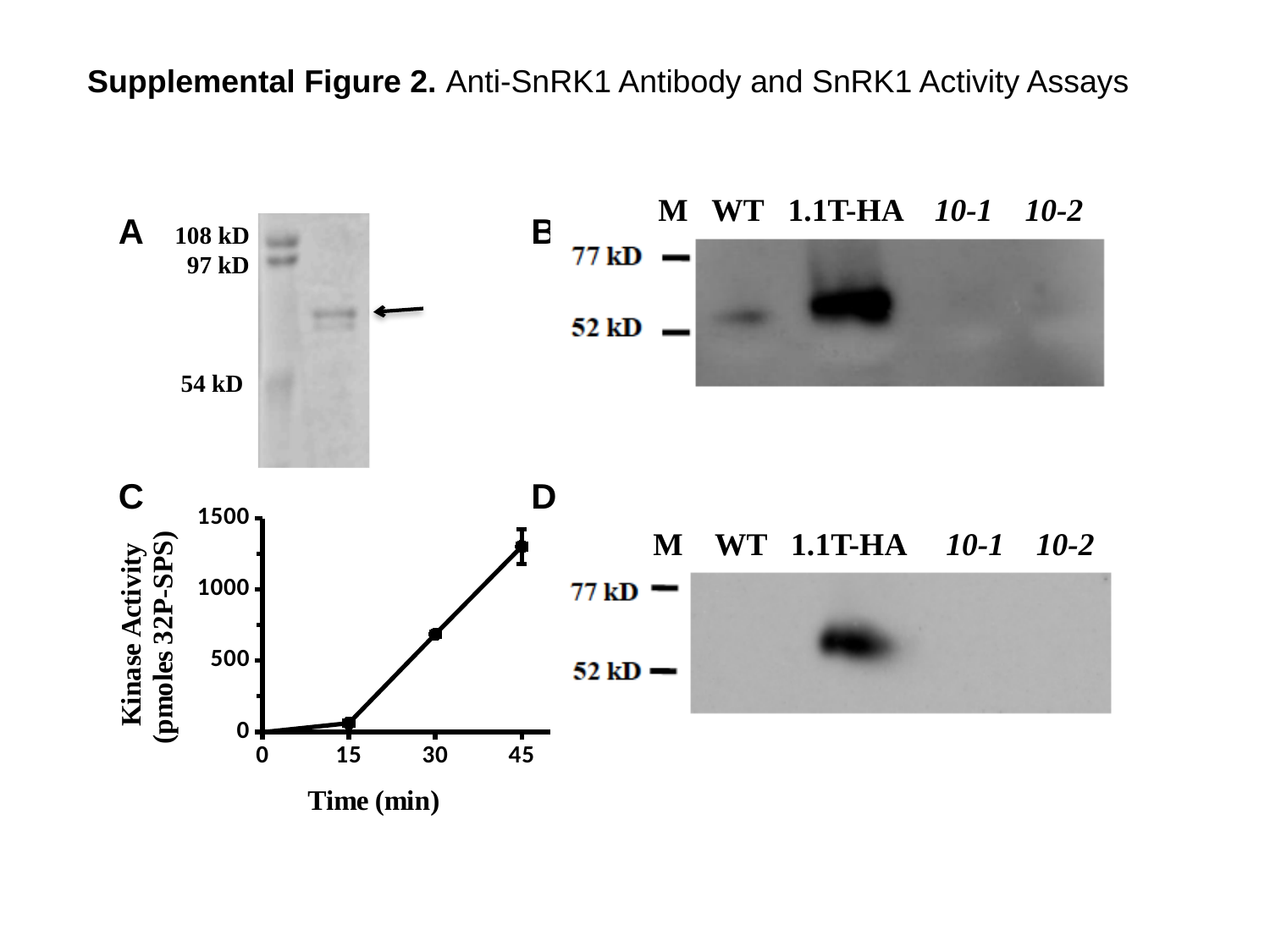
In panel C, how many time points are plotted? 4 In panel C, what is the label of the x axis? Time (min) In panel C, which has higher kinase activity, 15 min or 30 min? 30 min In panel C, is the kinase activity at 15 min greater or less than 500? less In panel C, is the kinase activity at 30 min greater or less than 1000? less In panel C, what is the label of the y axis? Kinase Activity (pmoles 32P-SPS) In panel C, is the kinase activity at 30 min greater or less than 500? greater In panel C, what kind of chart is shown? line chart In panel C, at which time point is kinase activity highest? 45 In panel C, does kinase activity rise or fall as time increases from 0 to 45 min? rise In panel C, which has higher kinase activity, 30 min or 45 min? 45 min